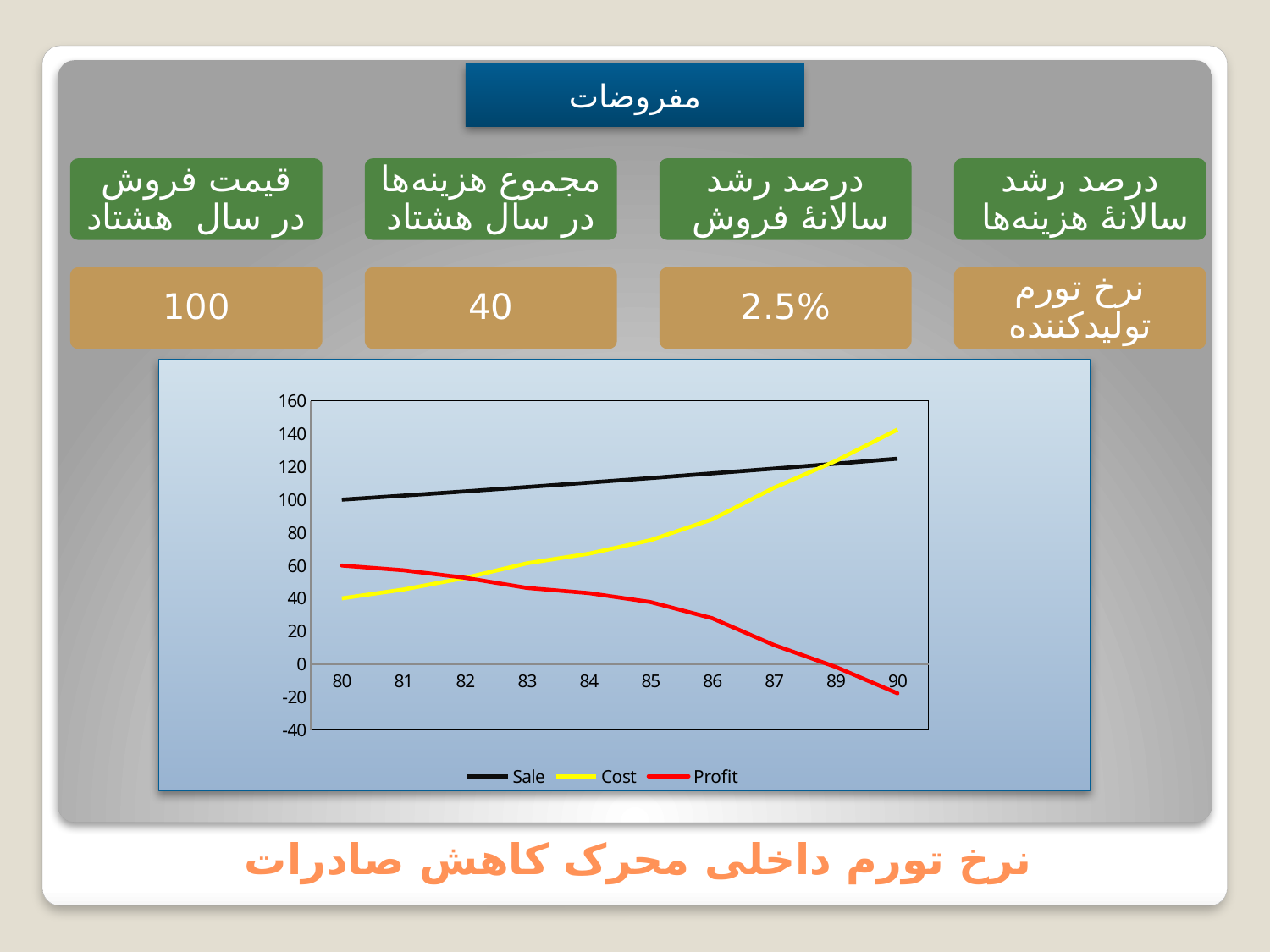
How many series does the chart legend list? 3 Does the Profit series rise or fall from year 80 to year 90? fall What is the value of the Cost series in year 80? 40 Is the value of the Profit series in year 90 greater or less than 0? less Is the value of the Cost series in year 90 greater or less than 120? greater What is the difference between the Sale value and the Cost value in year 80? 60 What type of chart is shown on the slide? line chart What is the value of the Sale series in year 80? 100 What is the value of the Profit series in year 80? 60 In year 90, which series has the larger value, Cost or Sale? Cost Does the Cost series rise or fall from year 80 to year 90? rise How many years are plotted along the x axis of the chart? 10